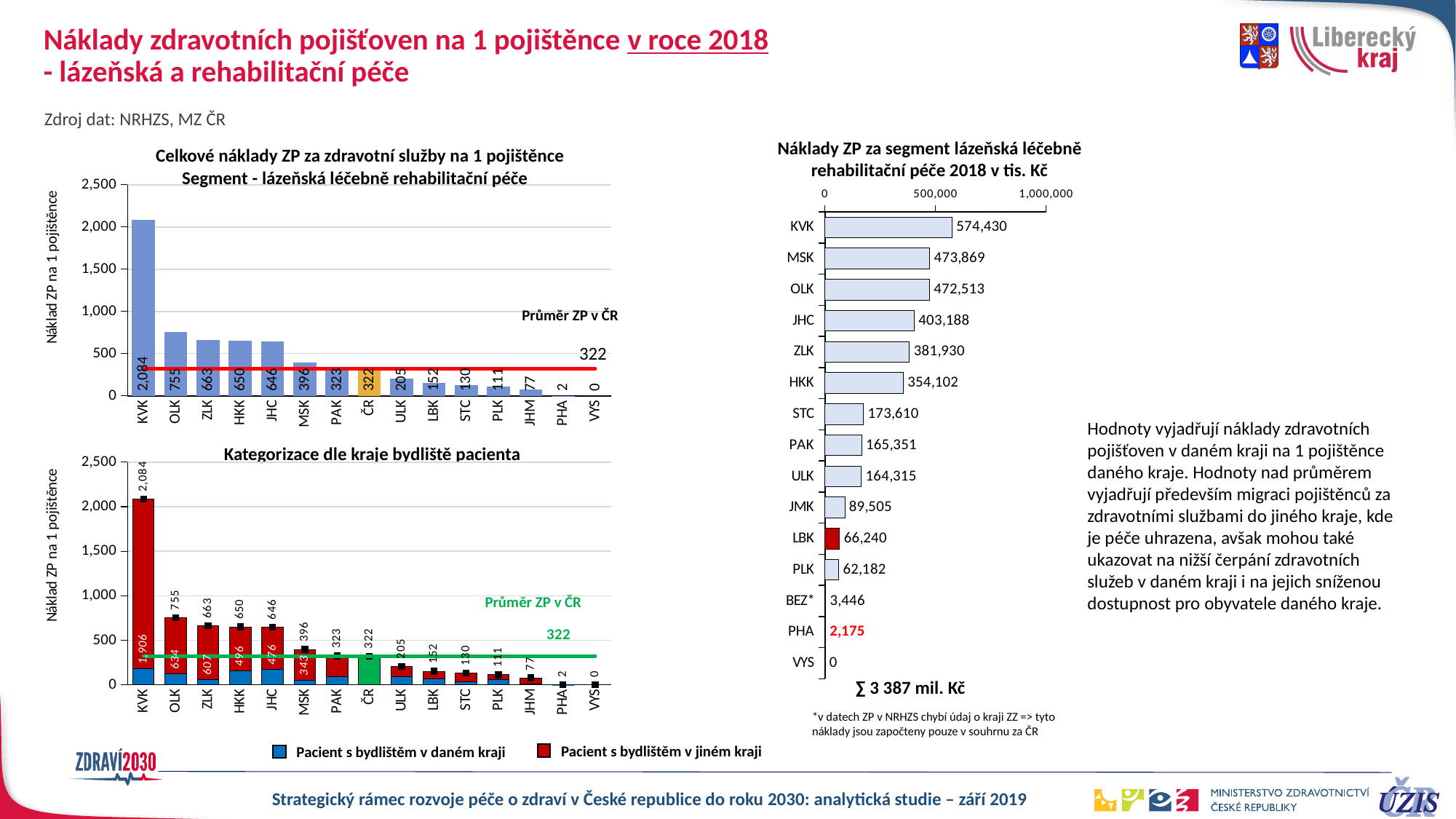
How many regions (categories) are shown in the chart 'Náklady ZP za segment lázeňská léčebně rehabilitační péče 2018 v tis. Kč'? 15 In the chart 'Celkové náklady ZP za zdravotní služby na 1 pojištěnce', what is the value of the ČR average line (Průměr ZP v ČR)? 322 How many series does the legend of the chart 'Kategorizace dle kraje bydliště pacienta' list? 2 In the chart 'Celkové náklady ZP za zdravotní služby na 1 pojištěnce', which region has the lowest value? VYS In the chart 'Kategorizace dle kraje bydliště pacienta', what is the value of the 'Pacient s bydlištěm v jiném kraji' segment for KVK? 1,906 In the chart 'Náklady ZP za segment lázeňská léčebně rehabilitační péče 2018 v tis. Kč', what is the value for LBK? 66,240 In the chart 'Náklady ZP za segment lázeňská léčebně rehabilitační péče 2018 v tis. Kč', which region has the highest value? KVK In the chart 'Celkové náklady ZP za zdravotní služby na 1 pojištěnce', what is the difference between OLK and ZLK? 92 What type of chart is 'Kategorizace dle kraje bydliště pacienta'? Stacked bar chart In the chart 'Náklady ZP za segment lázeňská léčebně rehabilitační péče 2018 v tis. Kč', which is larger, MSK or OLK? MSK In the chart 'Náklady ZP za segment lázeňská léčebně rehabilitační péče 2018 v tis. Kč', what total is shown below the bars? ∑ 3 387 mil. Kč In the chart 'Celkové náklady ZP za zdravotní služby na 1 pojištěnce', what is the value for KVK? 2,084